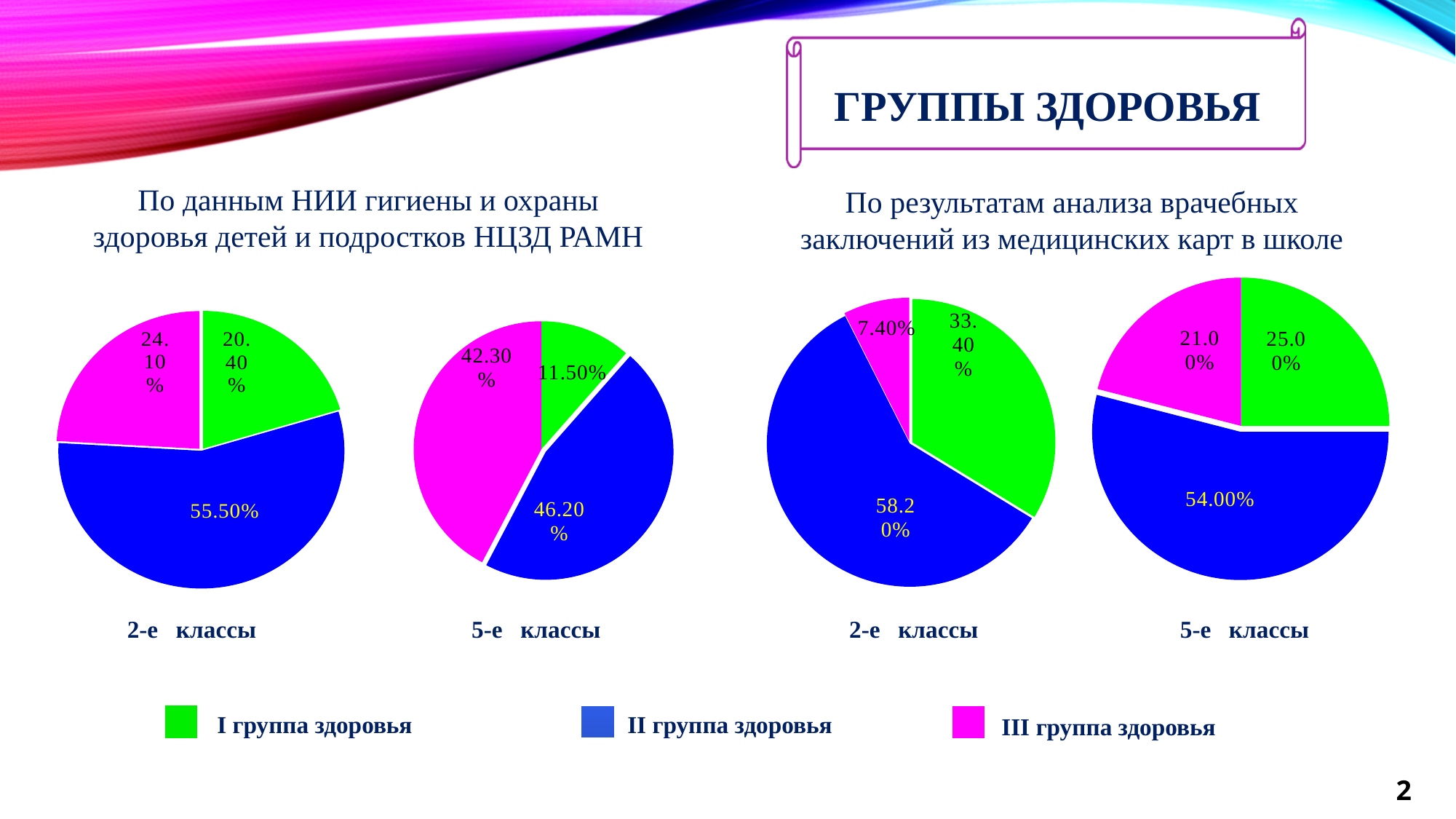
In the third pie chart from the left (2-е классы, school medical records), which health group has the smallest share? III группа здоровья In the second pie chart from the left (5-е классы, НИИ data), what is the difference between the II группа здоровья share and the III группа здоровья share? 3.90% In the rightmost pie chart (5-е классы, school medical records), what share is labelled for the blue slice (II группа здоровья)? 54.00% Which colour represents III группа здоровья in the legend? Magenta In the second pie chart from the left (5-е классы, НИИ data), what share is labelled for the green slice (I группа здоровья)? 11.50% How many entries does the legend at the bottom of the slide list? 3 In the leftmost pie chart (2-е классы, НИИ data), which health group has the largest share? II группа здоровья How many slices does each pie chart on the slide have? 3 In the rightmost pie chart (5-е классы, school medical records), which is larger: the share for I группа здоровья or for III группа здоровья? I группа здоровья What type of charts are shown on the slide? Pie charts In the third pie chart from the left (2-е классы, school medical records), what share is labelled for the magenta slice (III группа здоровья)? 7.40% In the leftmost pie chart (2-е классы, НИИ data), what share is labelled for the blue slice (II группа здоровья)? 55.50%